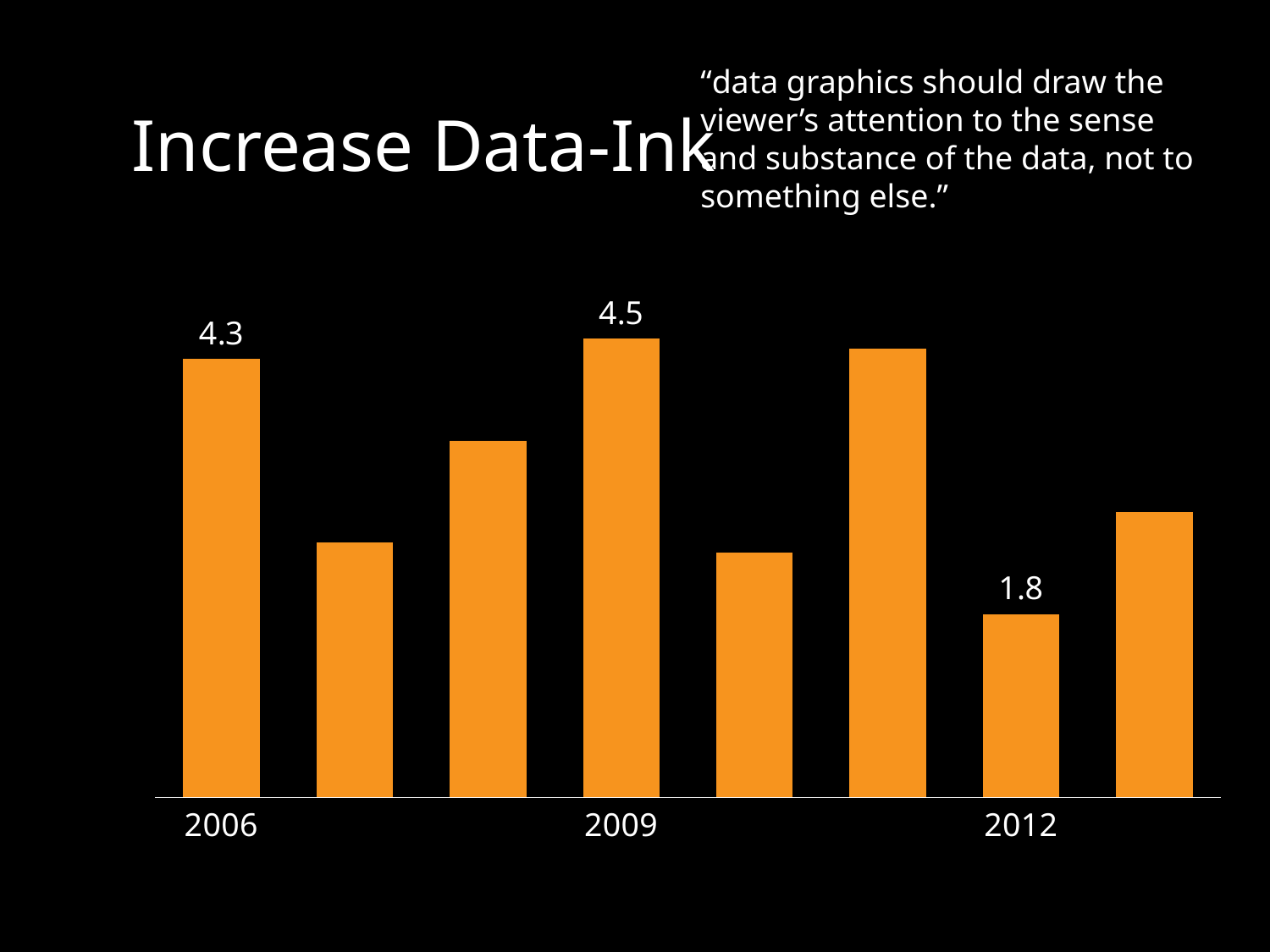
What is the value for 2006? 4.3 What is the value for 2012? 1.8 Which labelled year has the lowest value? 2012 What is the difference between the values for 2009 and 2012? 2.7 Which is larger, the value for 2006 or the value for 2012? 2006 What is the difference between the values for 2006 and 2012? 2.5 What kind of chart is shown on the slide? Bar chart What is the value for 2009? 4.5 What colour are the bars in the chart? Orange Which is larger, the value for 2009 or the value for 2012? 2009 How many bars are plotted in the chart? 8 What is the difference between the values for 2009 and 2006? 0.2